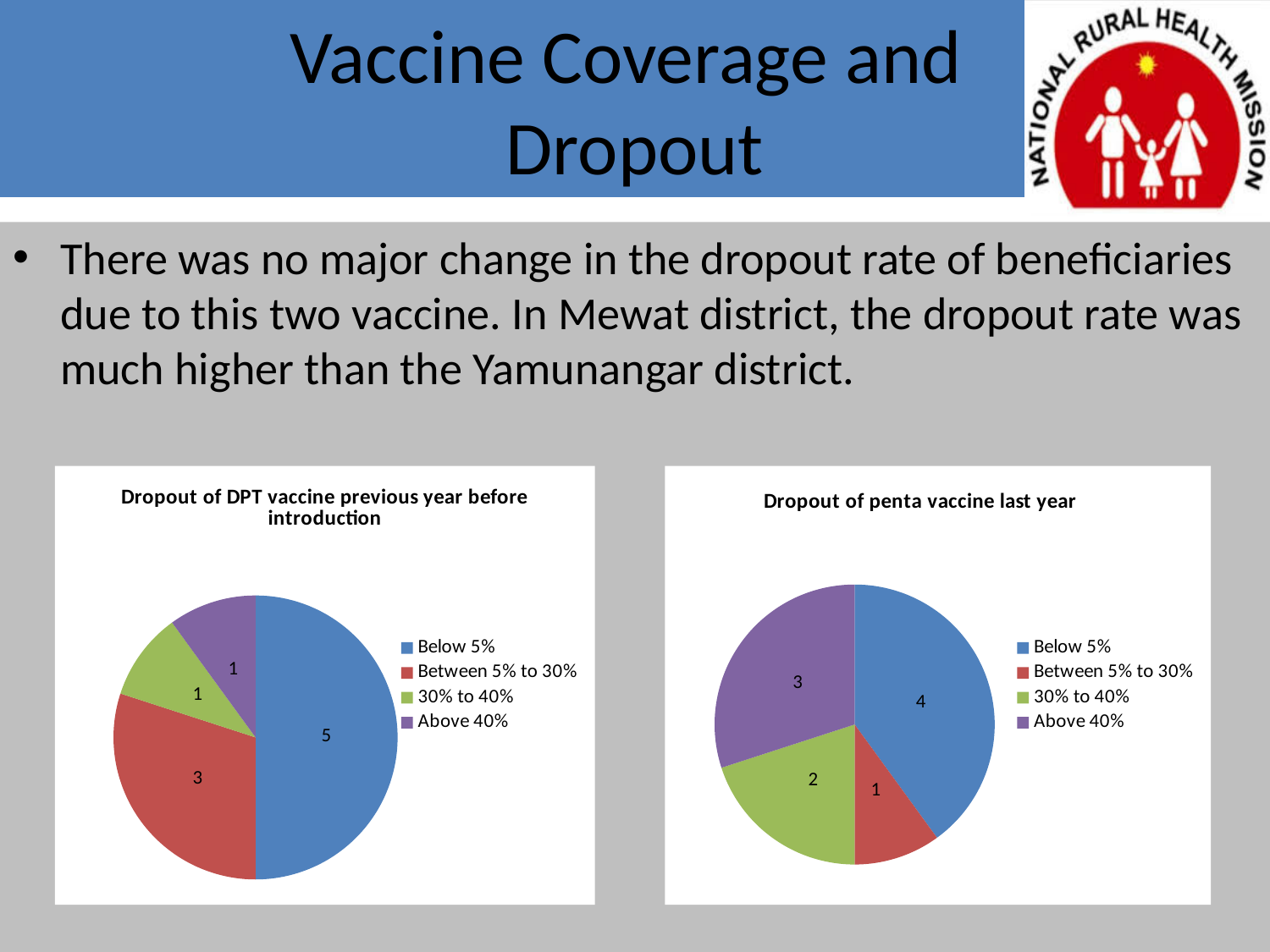
In the 'Dropout of DPT vaccine previous year before introduction' chart, what is the value for Below 5%? 5 In the 'Dropout of DPT vaccine previous year before introduction' chart, which is larger: Between 5% to 30% or Above 40%? Between 5% to 30% In the 'Dropout of penta vaccine last year' chart, what is the value for 30% to 40%? 2 In the 'Dropout of penta vaccine last year' chart, what is the difference between the Below 5% value and the Between 5% to 30% value? 3 What type of chart is the 'Dropout of DPT vaccine previous year before introduction' chart? Pie chart In the 'Dropout of DPT vaccine previous year before introduction' chart, what is the value for Between 5% to 30%? 3 In the 'Dropout of penta vaccine last year' chart, what share of the pie does the Below 5% slice represent? 40% How many categories does the legend of the 'Dropout of penta vaccine last year' chart list? 4 In the 'Dropout of penta vaccine last year' chart, which category has the smallest slice? Between 5% to 30% In the 'Dropout of DPT vaccine previous year before introduction' chart, what share of the pie does the Below 5% slice represent? 50% In the 'Dropout of DPT vaccine previous year before introduction' chart, which category has the largest slice? Below 5% In the 'Dropout of penta vaccine last year' chart, what is the value for Above 40%? 3